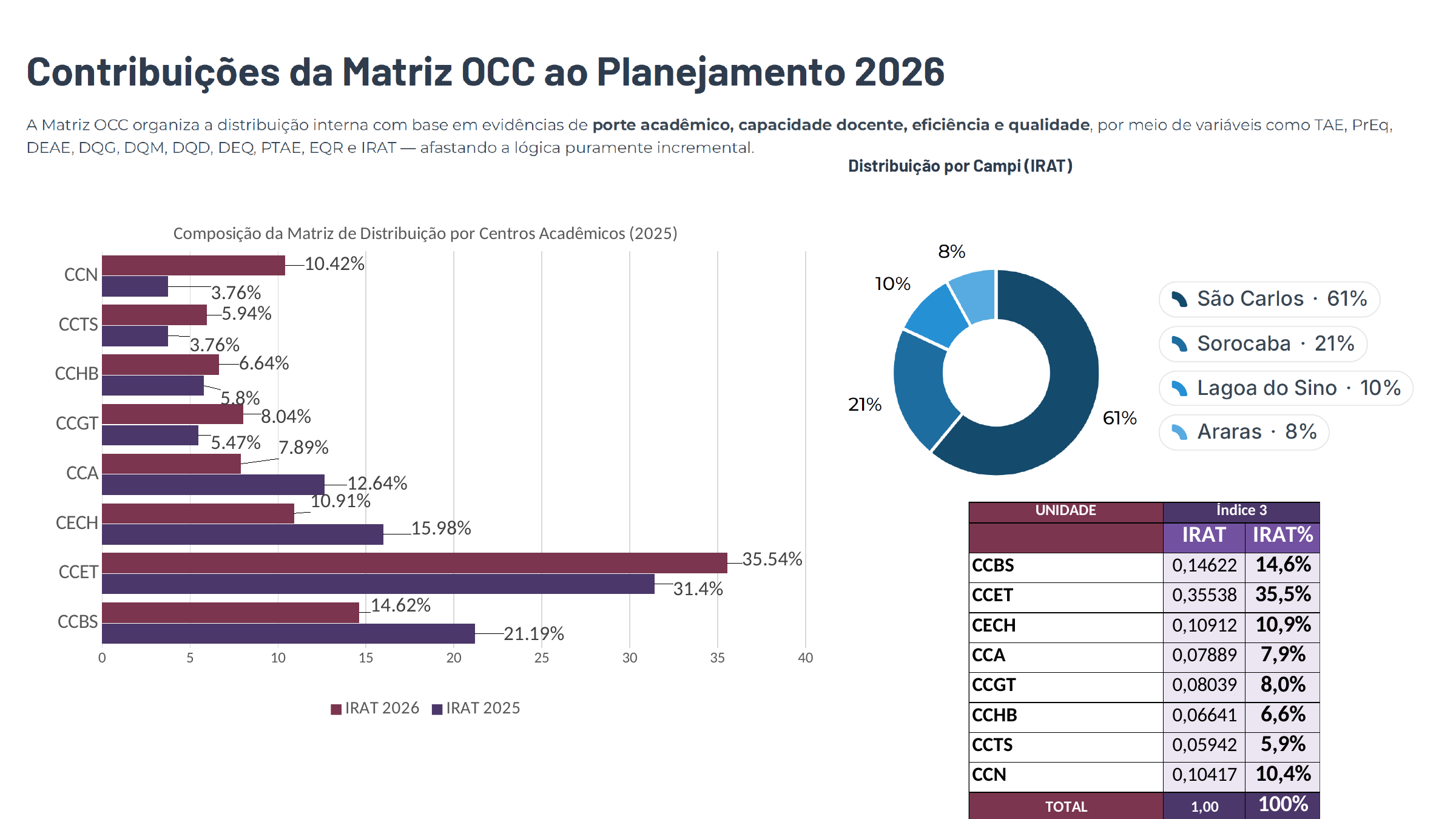
In the bar chart 'Composição da Matriz de Distribuição por Centros Acadêmicos (2025)', which centre has the lowest IRAT 2026 value? CCTS In the bar chart 'Composição da Matriz de Distribuição por Centros Acadêmicos (2025)', which centre has the highest IRAT 2026 value? CCET In the bar chart 'Composição da Matriz de Distribuição por Centros Acadêmicos (2025)', is the IRAT 2025 value for CECH larger or smaller than its IRAT 2026 value? larger In the bar chart 'Composição da Matriz de Distribuição por Centros Acadêmicos (2025)', what is the difference between the IRAT 2026 and IRAT 2025 values for CCN? 6.66% In the donut chart 'Distribuição por Campi (IRAT)', which campus has the smallest share? Araras In the donut chart 'Distribuição por Campi (IRAT)', what share does Sorocaba have? 21% In the bar chart 'Composição da Matriz de Distribuição por Centros Acadêmicos (2025)', what is the IRAT 2025 value for CCBS? 21.19% In the bar chart 'Composição da Matriz de Distribuição por Centros Acadêmicos (2025)', what is the IRAT 2026 value for CCET? 35.54% In the donut chart 'Distribuição por Campi (IRAT)', how many campi are shown? 4 In the bar chart 'Composição da Matriz de Distribuição por Centros Acadêmicos (2025)', how many academic centres are shown? 8 In the bar chart 'Composição da Matriz de Distribuição por Centros Acadêmicos (2025)', how many series does the legend list? 2 What kind of chart is 'Composição da Matriz de Distribuição por Centros Acadêmicos (2025)'? Bar chart